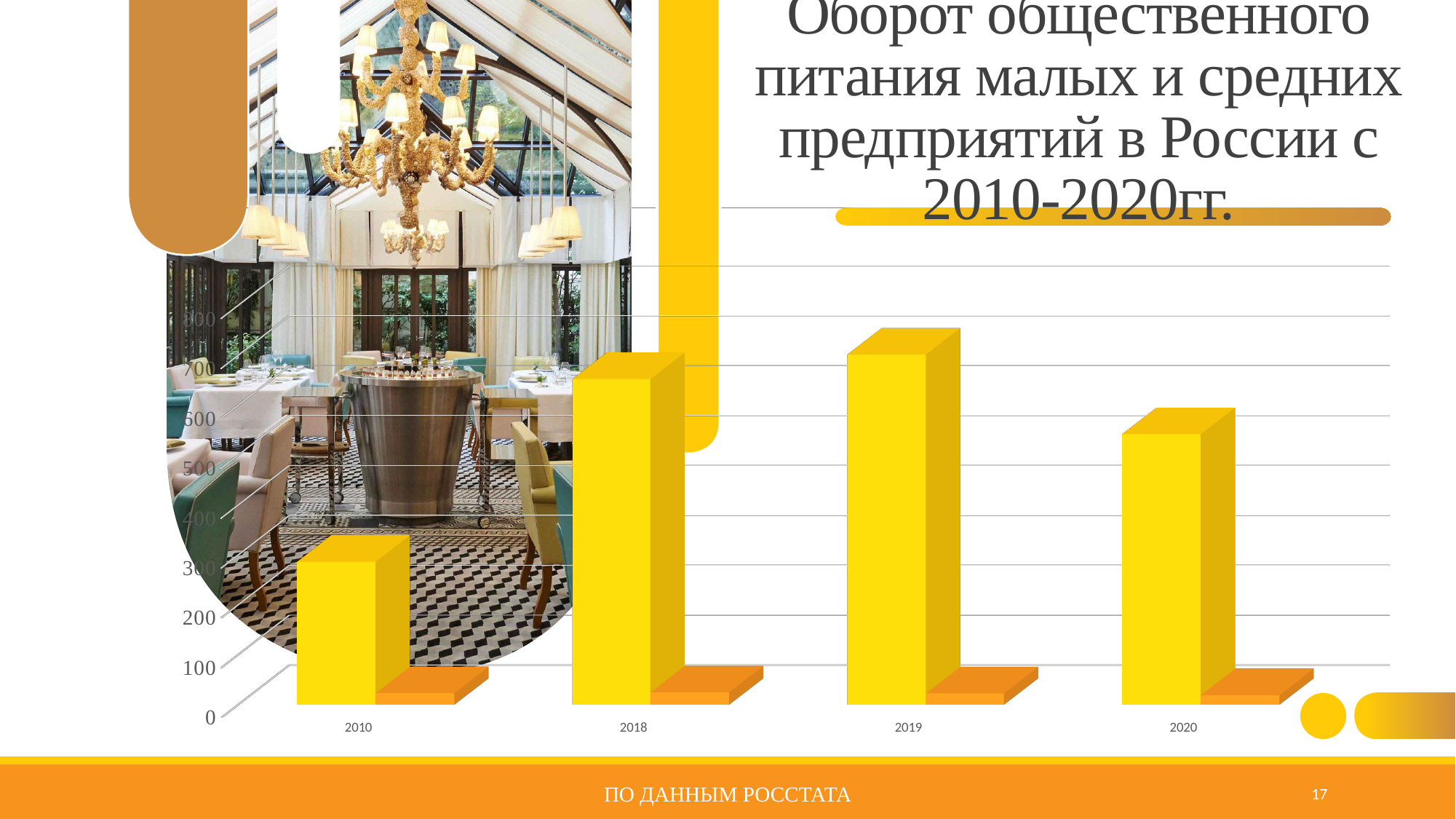
Is the value for 2019 greater or less than 600? greater Which year has the lowest bar on the chart? 2010 How many years (categories) are plotted on the chart? 4 How does the value change from 2019 to 2020? It falls Is the value for 2018 greater or less than 600? greater Which year has the larger value, 2010 or 2020? 2020 What kind of chart is shown on the slide? Bar chart Which year has the larger value, 2018 or 2020? 2018 Which year has the highest bar on the chart? 2019 Is the value for 2020 greater or less than 500? greater What is the title of the chart on the slide? Оборот общественного питания малых и средних предприятий в России с 2010-2020гг.